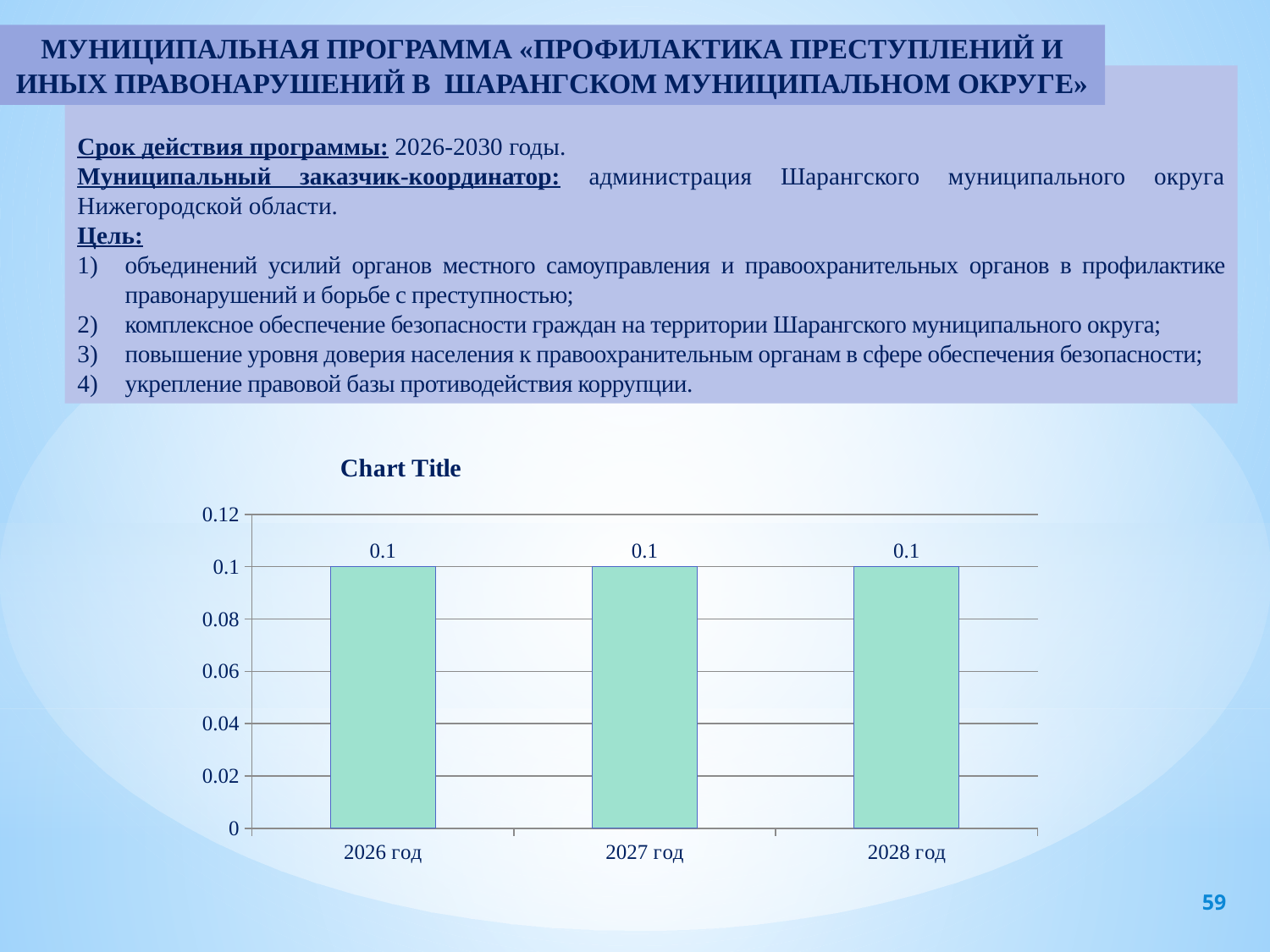
What is the difference between the values for 2026 год and 2028 год? 0 What is the value for 2028 год? 0.1 Do the values rise, fall or stay the same from 2026 год to 2028 год? stay the same Is the value for 2026 год greater or less than 0.12? less What is the title of the chart? Chart Title How many categories are plotted on the chart? 3 What kind of chart is shown on the slide? bar chart What is the value for 2026 год? 0.1 Is the value for 2027 год greater or less than 0.08? greater What is the value for 2027 год? 0.1 What is the highest value shown on the vertical axis of the chart? 0.12